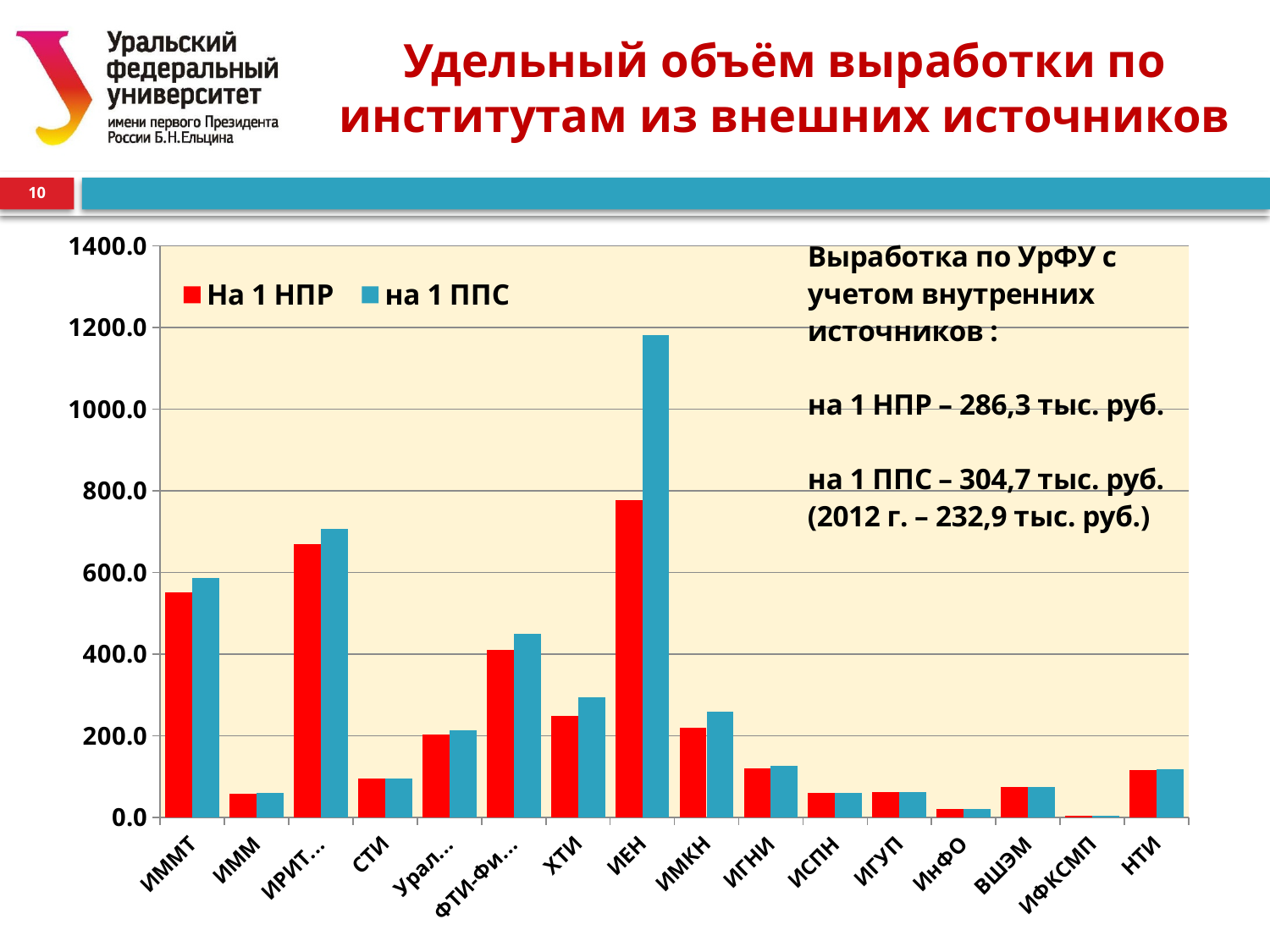
What kind of chart is shown on the slide? bar chart Which institute has the highest value for "на 1 ППС"? ИЕН How many series does the legend list? 2 Is the "на 1 ППС" value for ИЕН greater or less than 1000? greater Which institute has the highest value for "На 1 НПР"? ИЕН How many institutes (categories) are shown on the x axis? 16 Is the "на 1 ППС" value for ФТИ-Фи... greater or less than 400? greater For the "На 1 НПР" series, which is larger: ИММТ or ИРИТ...? ИРИТ... Which institute has the lowest value for "На 1 НПР"? ИФКСМП Is the "На 1 НПР" value for СТИ greater or less than 200? less Which series is shown in red in the legend? На 1 НПР